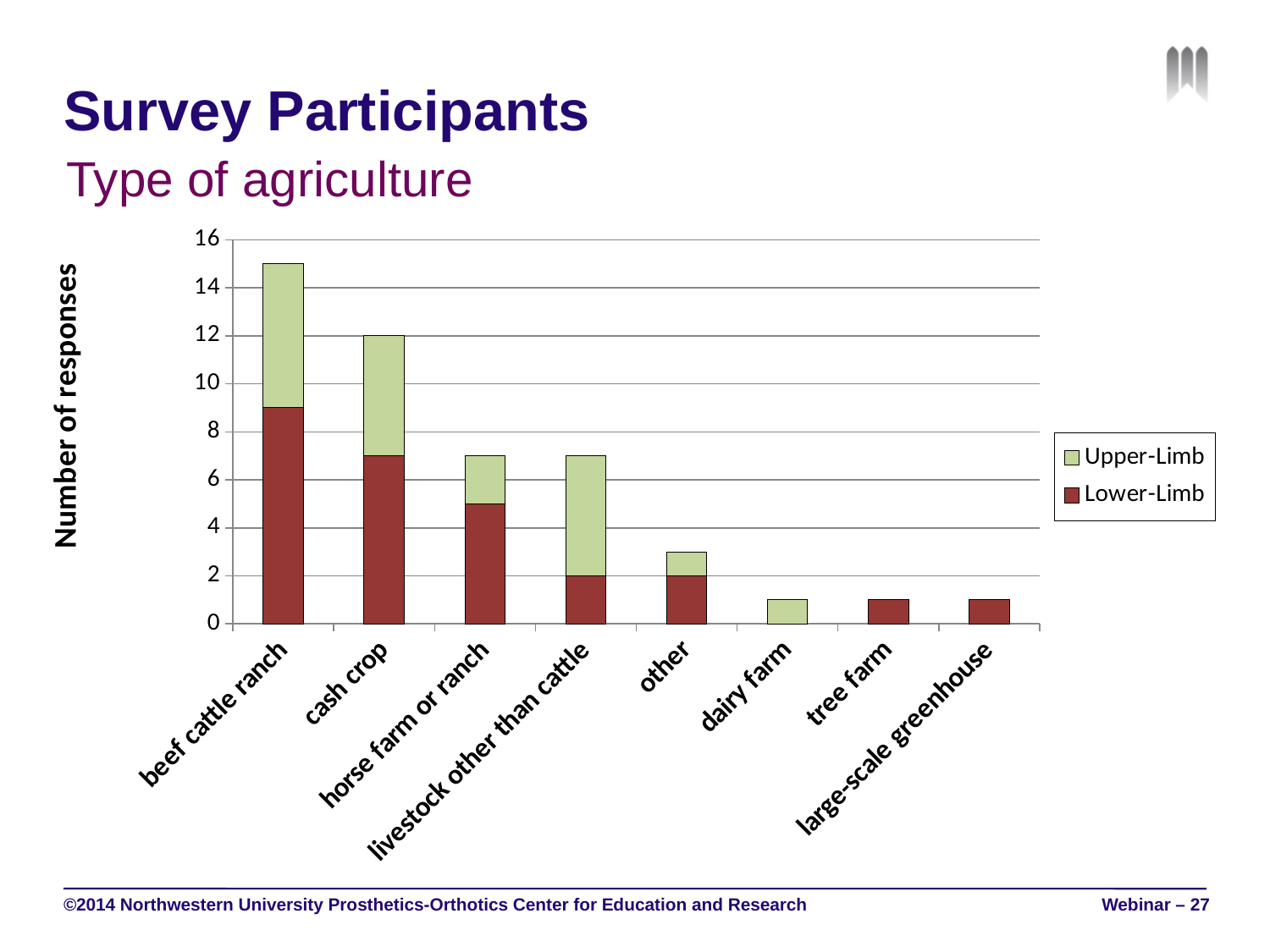
What is the Lower-Limb value for other? 2 What is the total number of responses for cash crop? 12 Is the Lower-Limb value for beef cattle ranch greater or less than 8? greater What kind of chart is shown on the slide? stacked bar chart How many types of agriculture are shown on the x axis? 8 Which has a larger total number of responses, cash crop or other? cash crop Is the total number of responses for beef cattle ranch greater or less than 14? greater What is the label of the y axis? Number of responses What is the Lower-Limb value for livestock other than cattle? 2 How many series does the legend list? 2 Which type of agriculture has the highest total number of responses? beef cattle ranch Is the total number of responses for horse farm or ranch greater or less than 6? greater